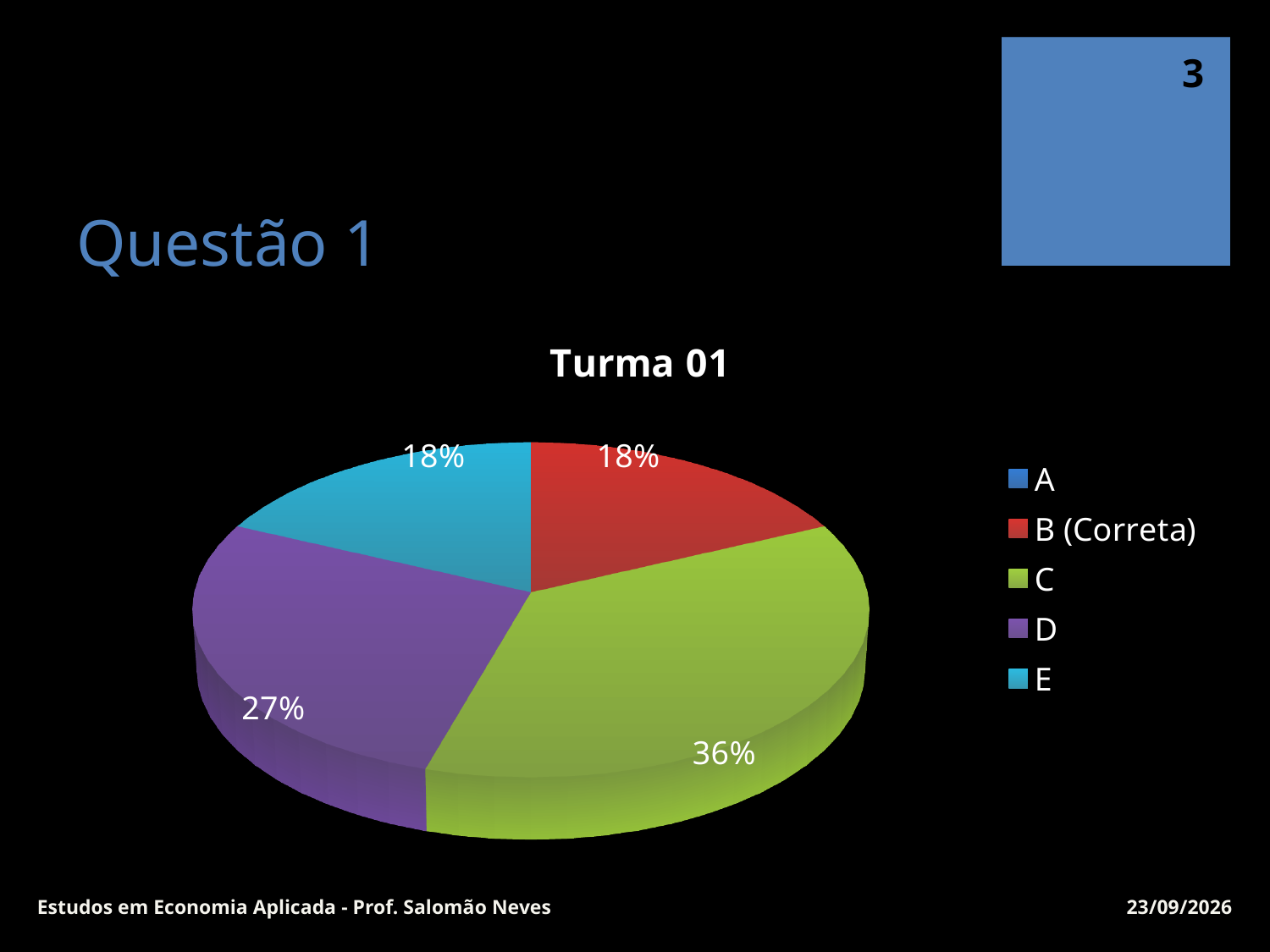
What percentage is shown for B (Correta) in the Turma 01 chart? 18% Which legend entry is marked as the correct answer in the Turma 01 chart? B (Correta) What is the difference in percentage points between C and D in the Turma 01 chart? 9 What is the title of the chart on the slide? Turma 01 Which category has the largest slice in the Turma 01 pie chart? C What share of the pie does C have in the Turma 01 chart? 36% What type of chart is shown on the slide? Pie chart What is the difference in percentage points between C and B (Correta) in the Turma 01 chart? 18 How many entries does the legend of the Turma 01 chart list? 5 Which slice is larger in the Turma 01 chart, D or E? D What share of the pie does D have in the Turma 01 chart? 27% What percentage is shown for E in the Turma 01 chart? 18%